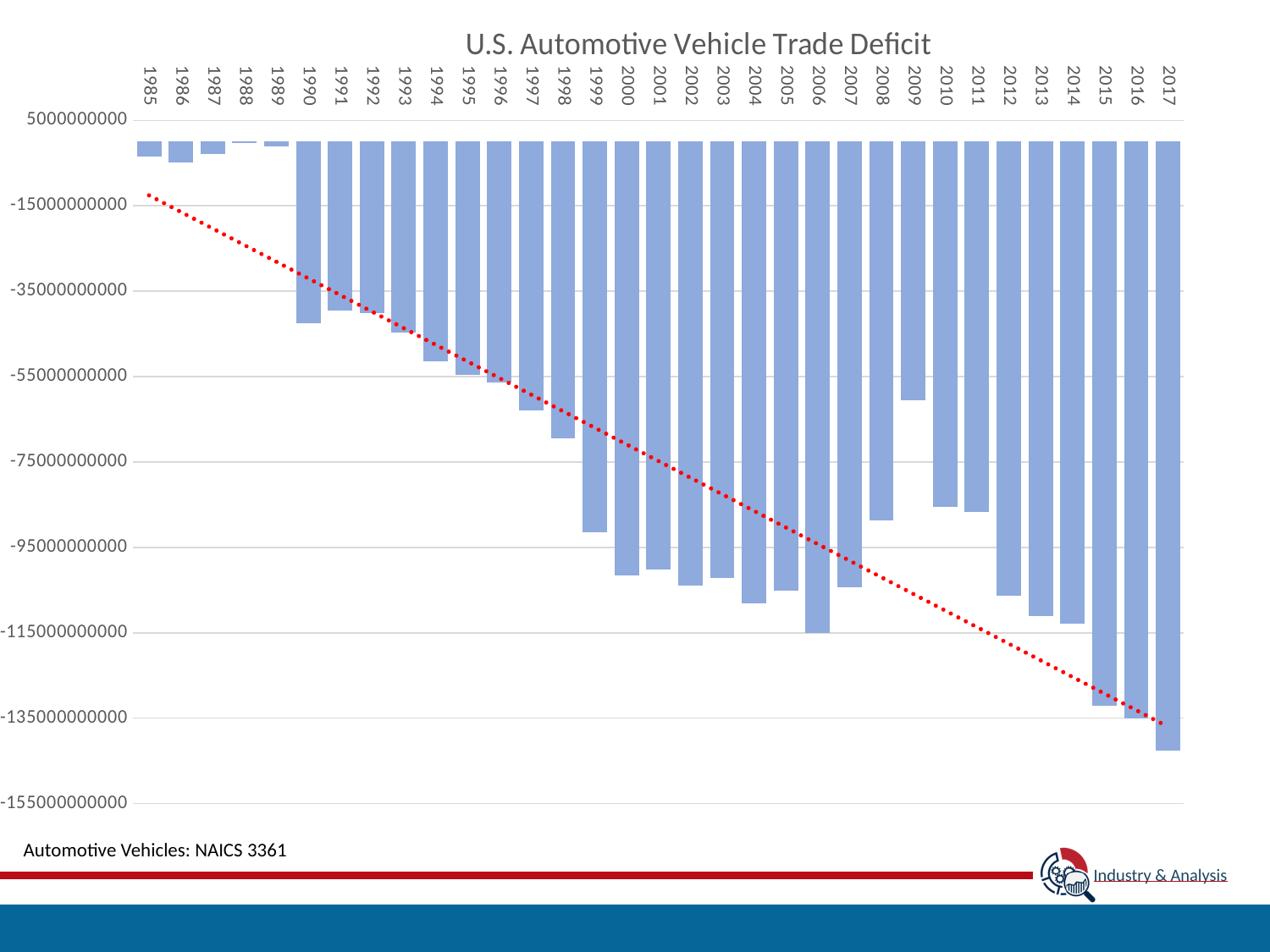
What is the title of the chart? U.S. Automotive Vehicle Trade Deficit Which year has the larger value, 2008 or 2009? 2009 Is the value for 1990 greater or less than -55000000000? greater How many years are plotted on the x axis of the chart? 33 Which year has the larger value, 1999 or 2000? 1999 What kind of chart is shown on the slide? bar chart Is the value for 2006 greater or less than -95000000000? less Do the values generally rise or fall from 1985 to 2017? fall Which year has the lowest (most negative) value in the chart? 2017 Is the value for 2017 greater or less than -135000000000? less What colour is the dotted trend line on the chart? red